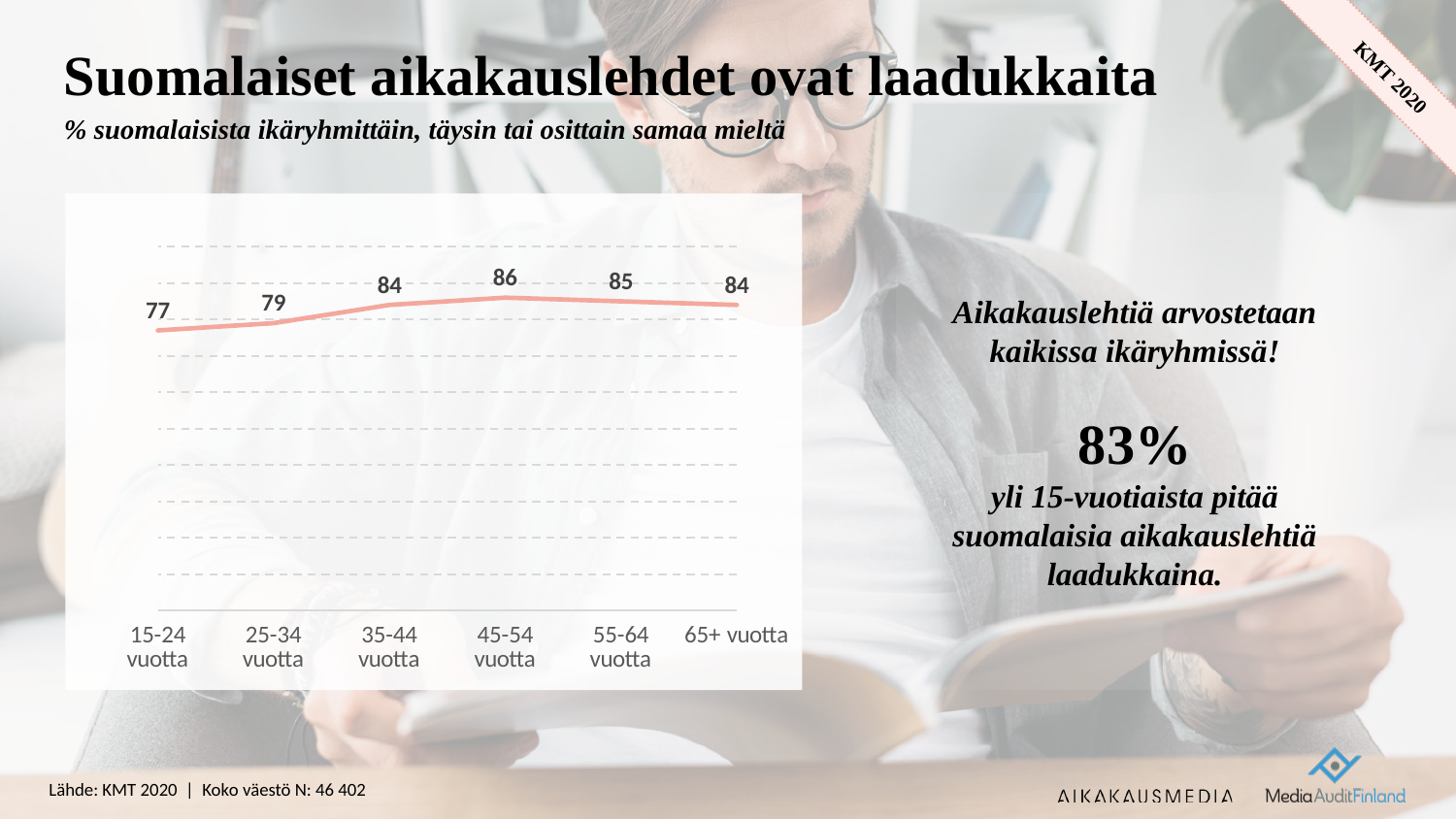
What is the value for the 65+ vuotta age group? 84 What is the difference between the values for 35-44 vuotta and 25-34 vuotta? 5 Which age group has the lowest value? 15-24 vuotta Do the values rise or fall from 15-24 vuotta to 45-54 vuotta? Rise What kind of chart is shown on the slide? Line chart What is the difference between the values for 45-54 vuotta and 15-24 vuotta? 9 What is the title of the slide containing the chart? Suomalaiset aikakauslehdet ovat laadukkaita What is the value for the 15-24 vuotta age group? 77 How many age groups are plotted on the chart? 6 Which is larger, the value for 25-34 vuotta or the value for 55-64 vuotta? 55-64 vuotta Which age group has the highest value? 45-54 vuotta What is the value for the 45-54 vuotta age group? 86